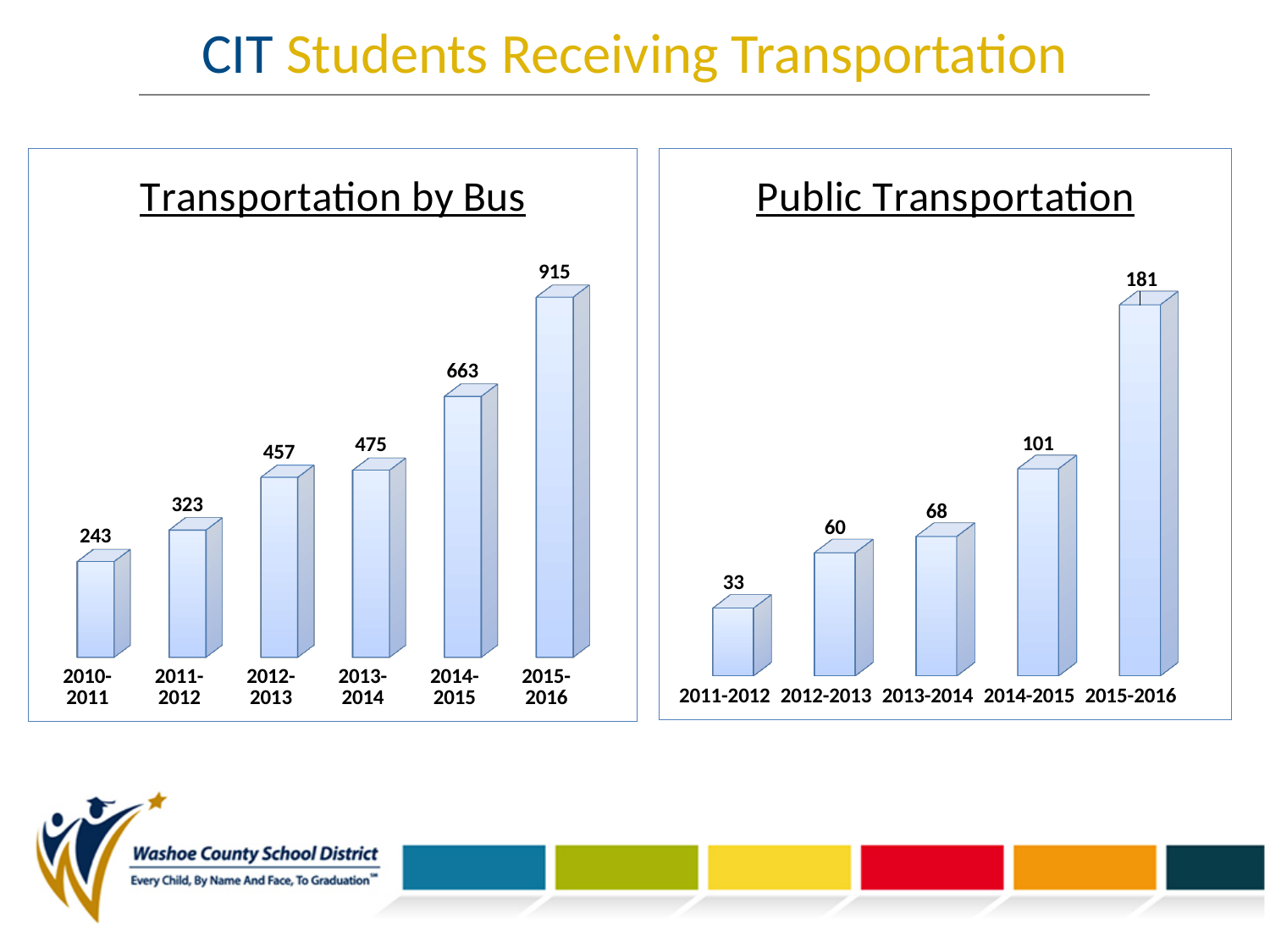
How many years are shown in the Public Transportation chart? 5 In the Transportation by Bus chart, what is the difference between the values for 2014-2015 and 2013-2014? 188 In the Public Transportation chart, what is the value for 2014-2015? 101 In the Transportation by Bus chart, what is the value for 2010-2011? 243 In the Transportation by Bus chart, what is the value for 2015-2016? 915 In the Public Transportation chart, what is the difference between the values for 2015-2016 and 2014-2015? 80 In the Transportation by Bus chart, which year has the highest value? 2015-2016 In the Public Transportation chart, which is larger, the value for 2012-2013 or 2013-2014? 2013-2014 In the Public Transportation chart, which year has the lowest value? 2011-2012 In the Transportation by Bus chart, do the values rise or fall from 2010-2011 to 2015-2016? Rise How many years are shown in the Transportation by Bus chart? 6 What kind of chart is the Public Transportation chart? Bar chart